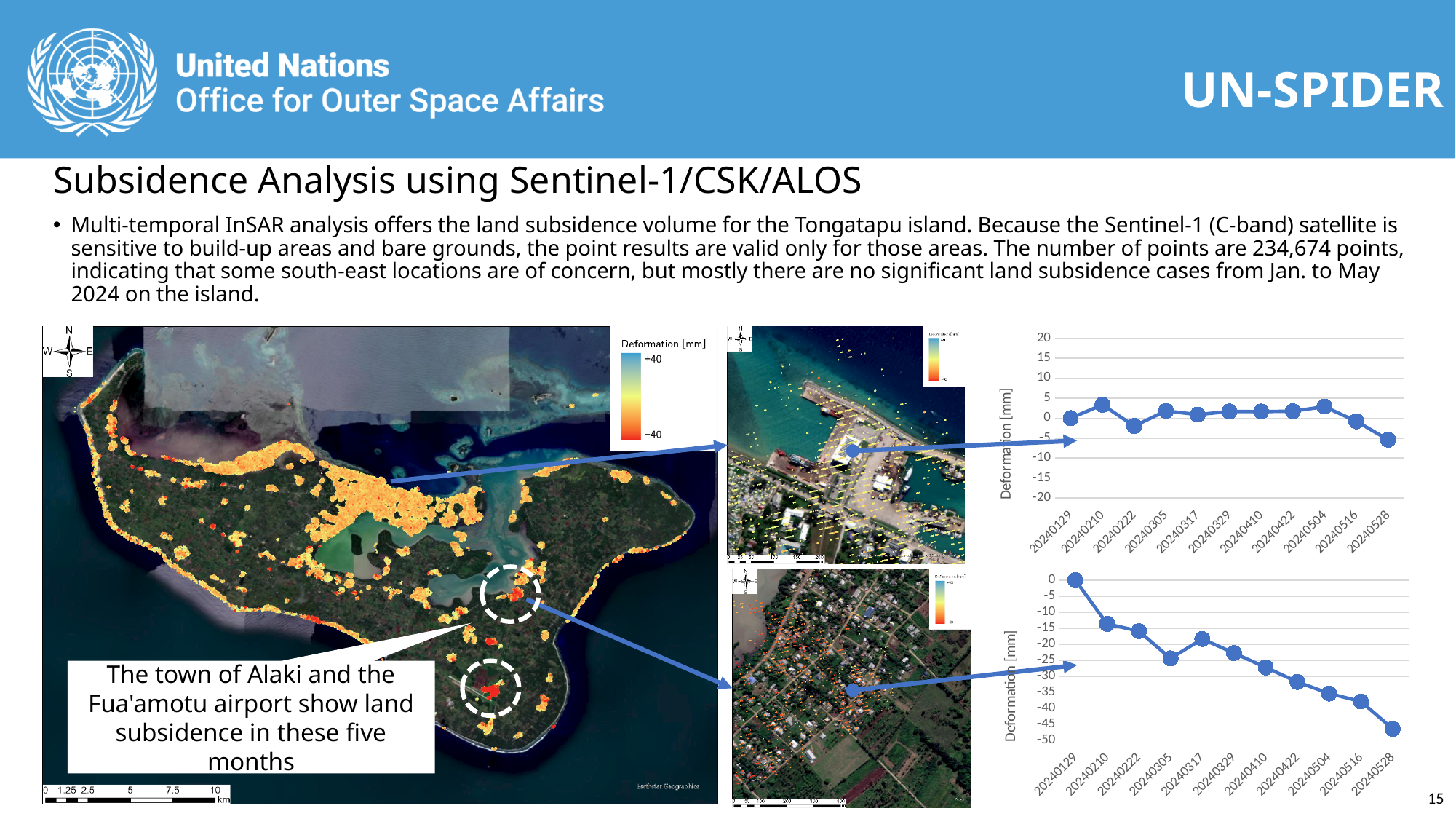
In the top line chart on the right, which date has the lowest deformation value? 20240528 How many data points are plotted in the bottom line chart on the right? 11 In the bottom line chart on the right, is the value for 20240305 greater or less than -20? less What is the y-axis label of the line charts on the right side of the slide? Deformation [mm] In the bottom line chart on the right, do the values rise or fall from 20240129 to 20240528? fall In the bottom line chart on the right, which date has the lowest deformation value? 20240528 In the bottom line chart on the right, which is larger, the value for 20240305 or the value for 20240317? 20240317 In the bottom line chart on the right, which date has the highest deformation value? 20240129 In the bottom line chart on the right, is the value for 20240528 greater or less than -40? less What kind of chart is the top chart on the right side of the slide? line chart In the bottom line chart on the right, what is the deformation value for 20240129? 0 In the top line chart on the right, is the value for 20240210 greater or less than 0? greater